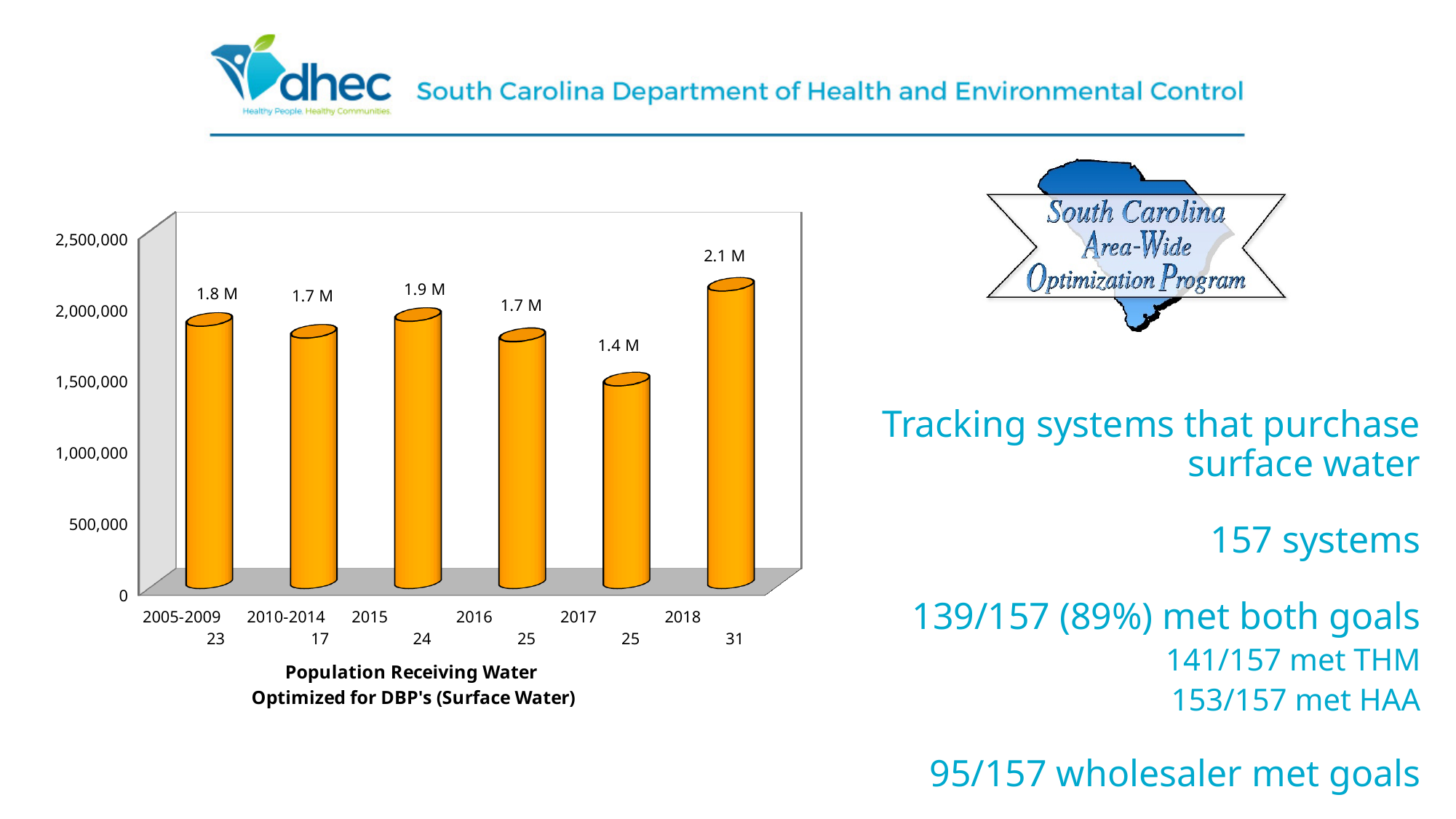
Is the value for 2017 greater or less than 1,500,000? less What is the title of the chart? Population Receiving Water Optimized for DBP's (Surface Water) What type of chart is shown on the slide? bar chart What is the population receiving water optimized for DBP's in 2018? 2.1 M What is the difference between the 2018 value and the 2017 value? 0.7 M Which period has the lowest population receiving water optimized for DBP's? 2017 How many bars are shown in the chart? 6 What is the value shown for the 2005-2009 bar? 1.8 M Which is larger, the value for 2015 or the value for 2016? 2015 What is the population receiving water optimized for DBP's in 2017? 1.4 M What is the value shown for the 2015 bar? 1.9 M Which period has the highest population receiving water optimized for DBP's? 2018